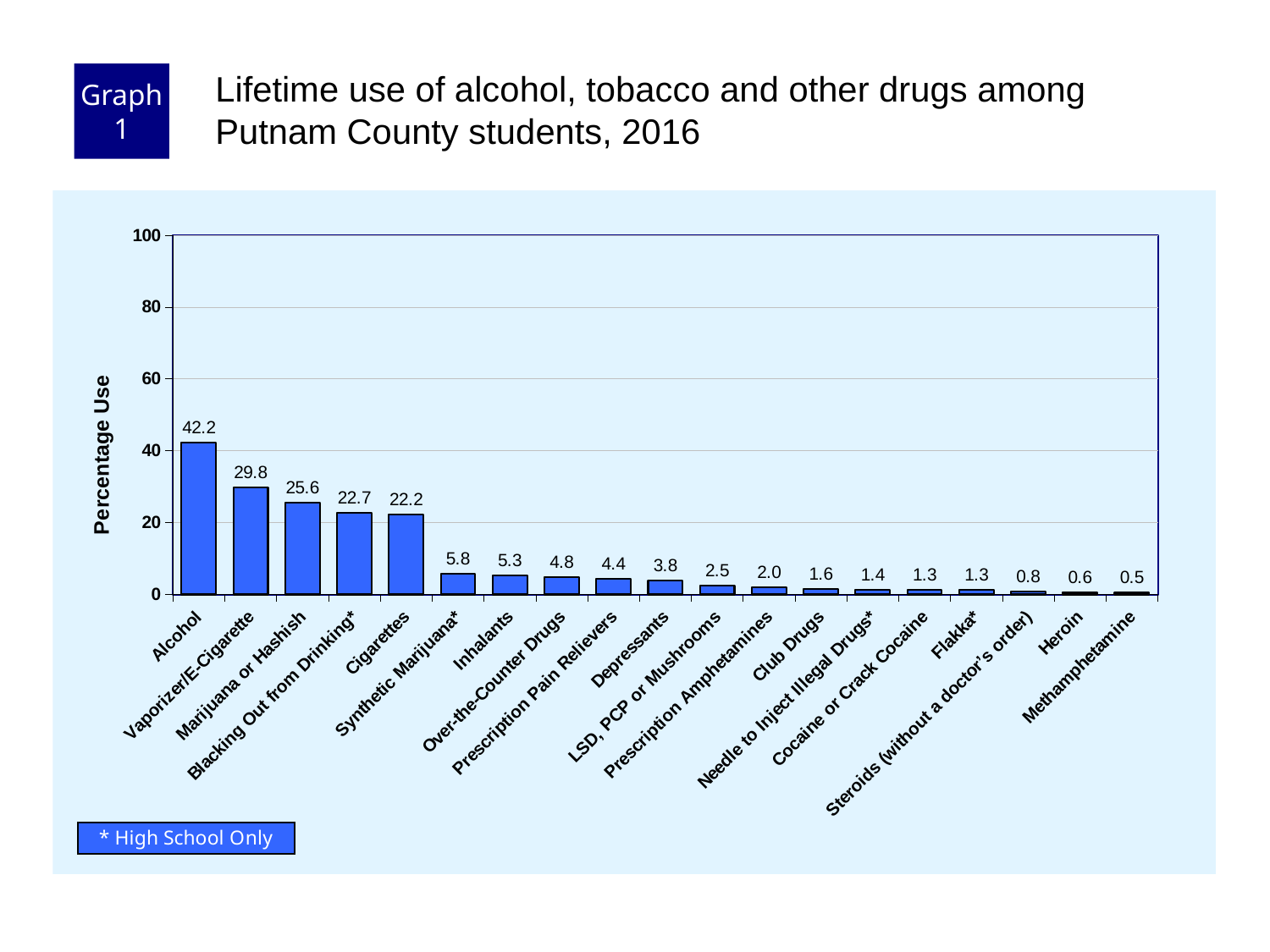
How many categories are shown on the x axis? 19 What kind of chart is shown on the slide? Bar chart What is the difference in percentage use between Alcohol and Cigarettes? 20.0 What is the label of the y axis? Percentage Use Which category has the highest percentage use? Alcohol Which category has the lowest percentage use? Methamphetamine What is the percentage use for Heroin? 0.6 Which has a higher percentage use, Marijuana or Hashish or Blacking Out from Drinking*? Marijuana or Hashish Is the value for Vaporizer/E-Cigarette greater or less than 20? greater What is the percentage use for Inhalants? 5.3 What is the percentage use for Alcohol? 42.2 What is the percentage use for Vaporizer/E-Cigarette? 29.8